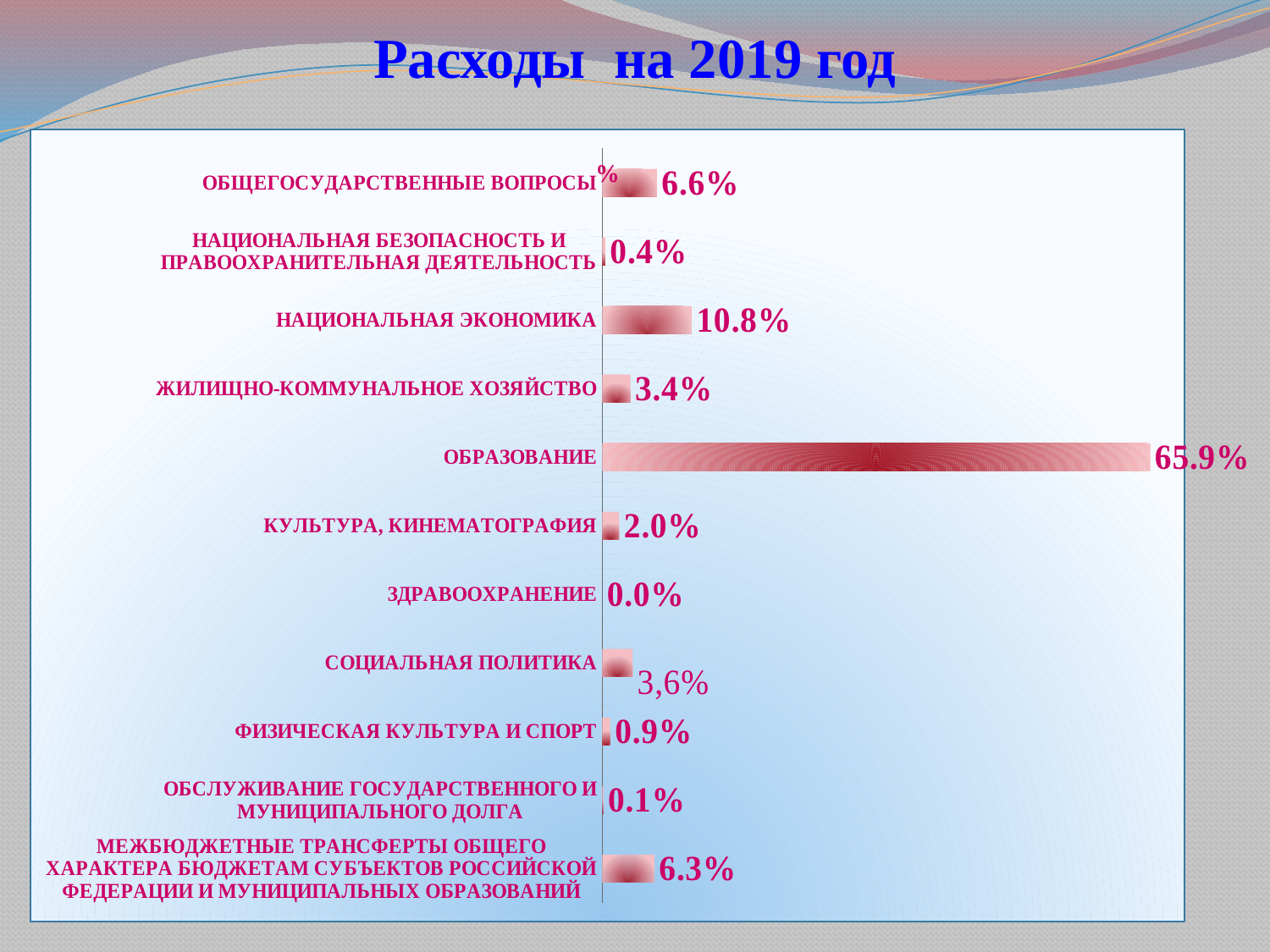
Which category has the lowest value? ЗДРАВООХРАНЕНИЕ What is the value for ОБРАЗОВАНИЕ? 65.9% What is the title of the chart? Расходы на 2019 год What is the value for ЖИЛИЩНО-КОММУНАЛЬНОЕ ХОЗЯЙСТВО? 3.4% What is the value for ОБСЛУЖИВАНИЕ ГОСУДАРСТВЕННОГО И МУНИЦИПАЛЬНОГО ДОЛГА? 0.1% Which category has the highest value? ОБРАЗОВАНИЕ What is the value for ФИЗИЧЕСКАЯ КУЛЬТУРА И СПОРТ? 0.9% What is the value for НАЦИОНАЛЬНАЯ ЭКОНОМИКА? 10.8% What is the difference between the values for НАЦИОНАЛЬНАЯ ЭКОНОМИКА and ОБЩЕГОСУДАРСТВЕННЫЕ ВОПРОСЫ? 4.2% Which is larger, the value for ОБЩЕГОСУДАРСТВЕННЫЕ ВОПРОСЫ or the value for МЕЖБЮДЖЕТНЫЕ ТРАНСФЕРТЫ ОБЩЕГО ХАРАКТЕРА БЮДЖЕТАМ СУБЪЕКТОВ РОССИЙСКОЙ ФЕДЕРАЦИИ И МУНИЦИПАЛЬНЫХ ОБРАЗОВАНИЙ? ОБЩЕГОСУДАРСТВЕННЫЕ ВОПРОСЫ What kind of chart is shown on the slide? bar chart How many categories are shown in the chart? 11